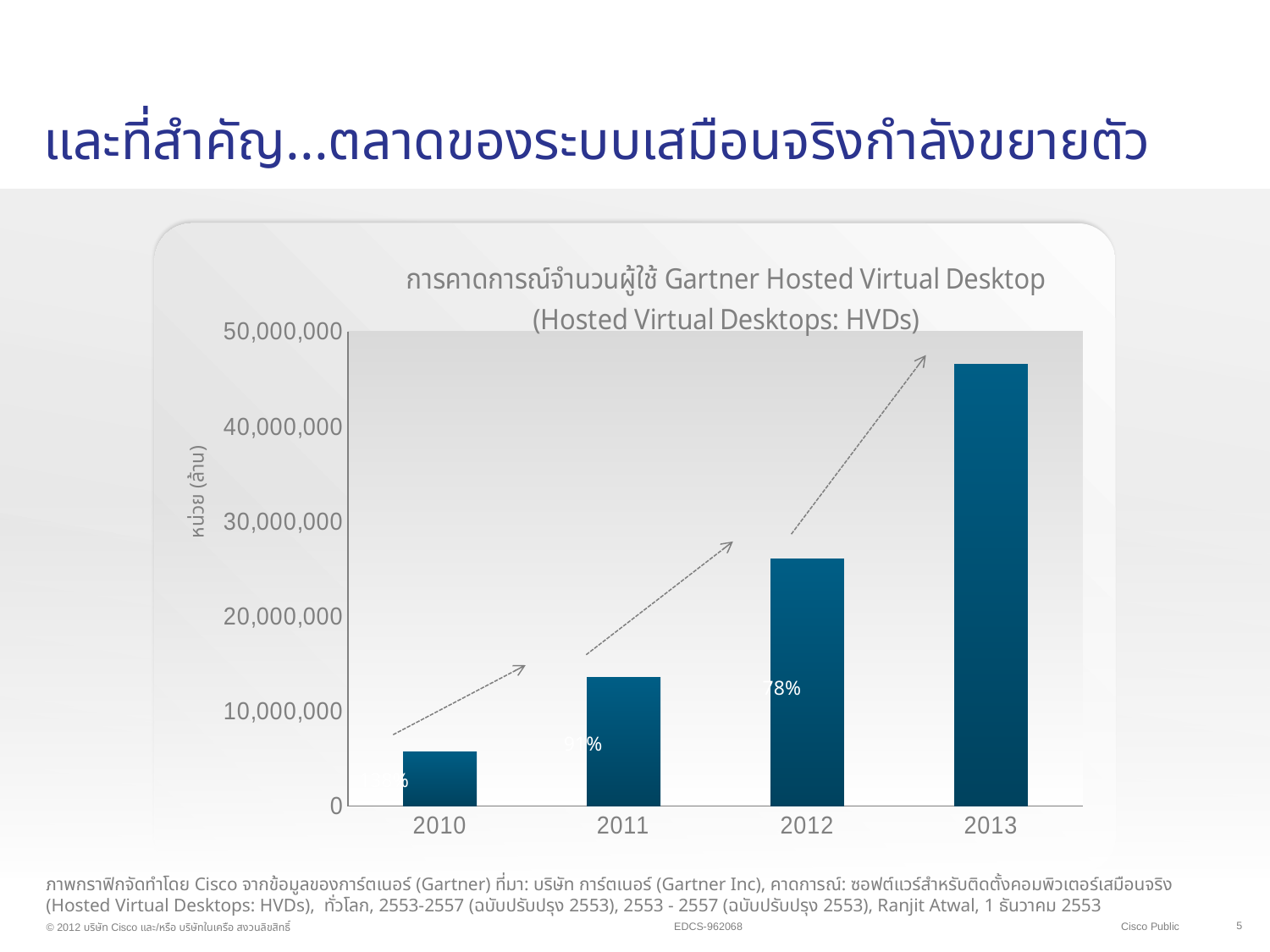
What kind of chart is shown on the slide? bar chart Which year has the highest bar in the chart? 2013 What is the first year shown on the x axis of the chart? 2010 Do the values rise or fall from 2010 to 2013? rise What is the highest tick value shown on the y axis of the chart? 50,000,000 Which year has the lowest bar in the chart? 2010 Is the value for 2011 greater or less than 20,000,000? less Is the value for 2012 greater or less than 20,000,000? greater Is the value for 2010 greater or less than 10,000,000? less Which year has the larger value, 2011 or 2012? 2012 How many years are shown on the x axis of the chart? 4